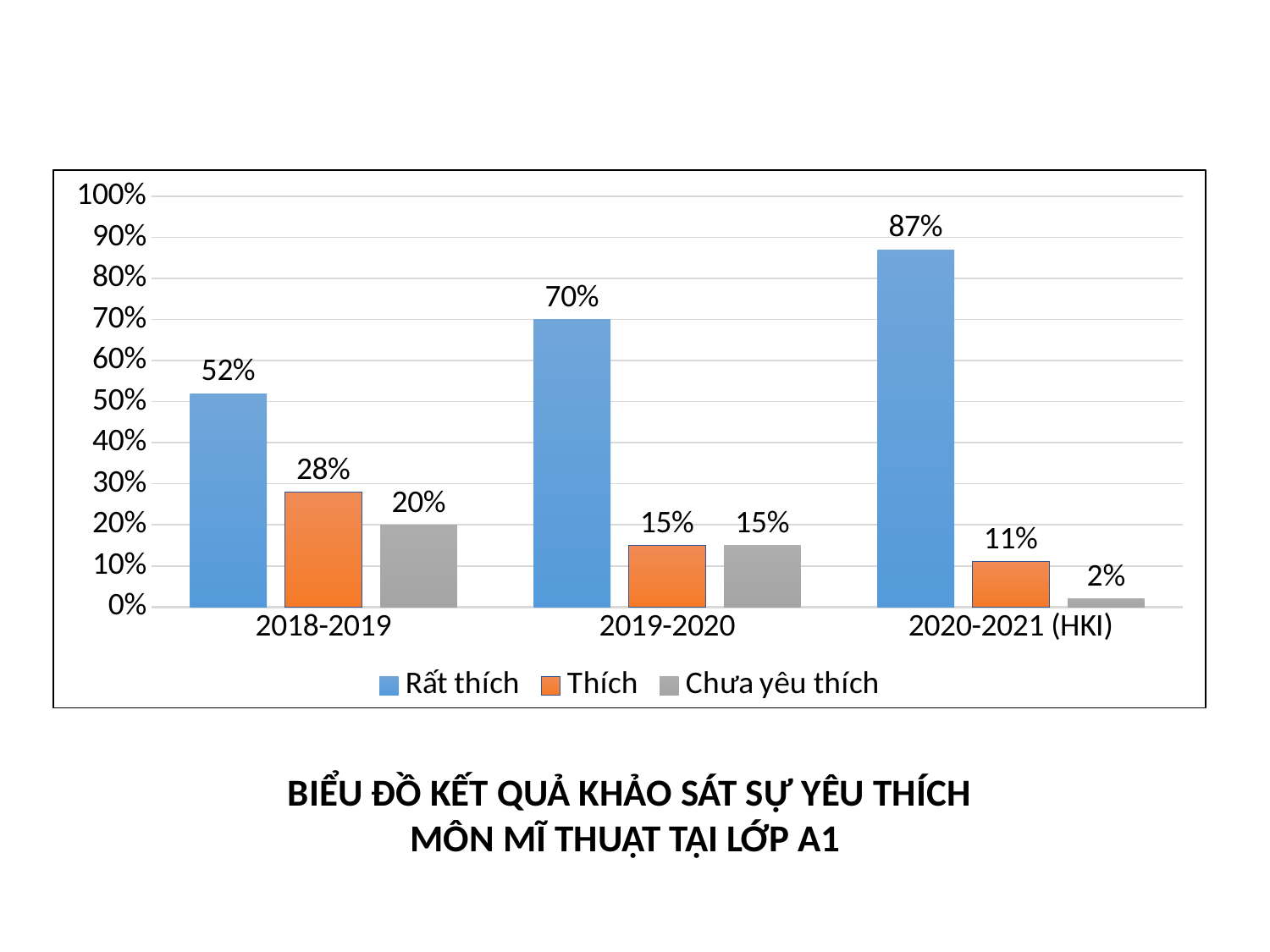
How many series does the legend list? 3 Is the value for Rất thích in 2019-2020 greater or less than 60%? greater What is the value for Chưa yêu thích in 2020-2021 (HKI)? 2% Does the Rất thích series rise or fall across the periods from 2018-2019 to 2020-2021 (HKI)? rise How many periods are shown on the x axis? 3 In which period is the Thích value lowest? 2020-2021 (HKI) In which period is the Rất thích value highest? 2020-2021 (HKI) What kind of chart is shown? bar chart Which is larger: Thích in 2018-2019 or Chưa yêu thích in 2018-2019? Thích in 2018-2019 What is the value for Thích in 2019-2020? 15% What is the difference between the Rất thích values for 2020-2021 (HKI) and 2018-2019? 35% What is the value for Rất thích in 2018-2019? 52%